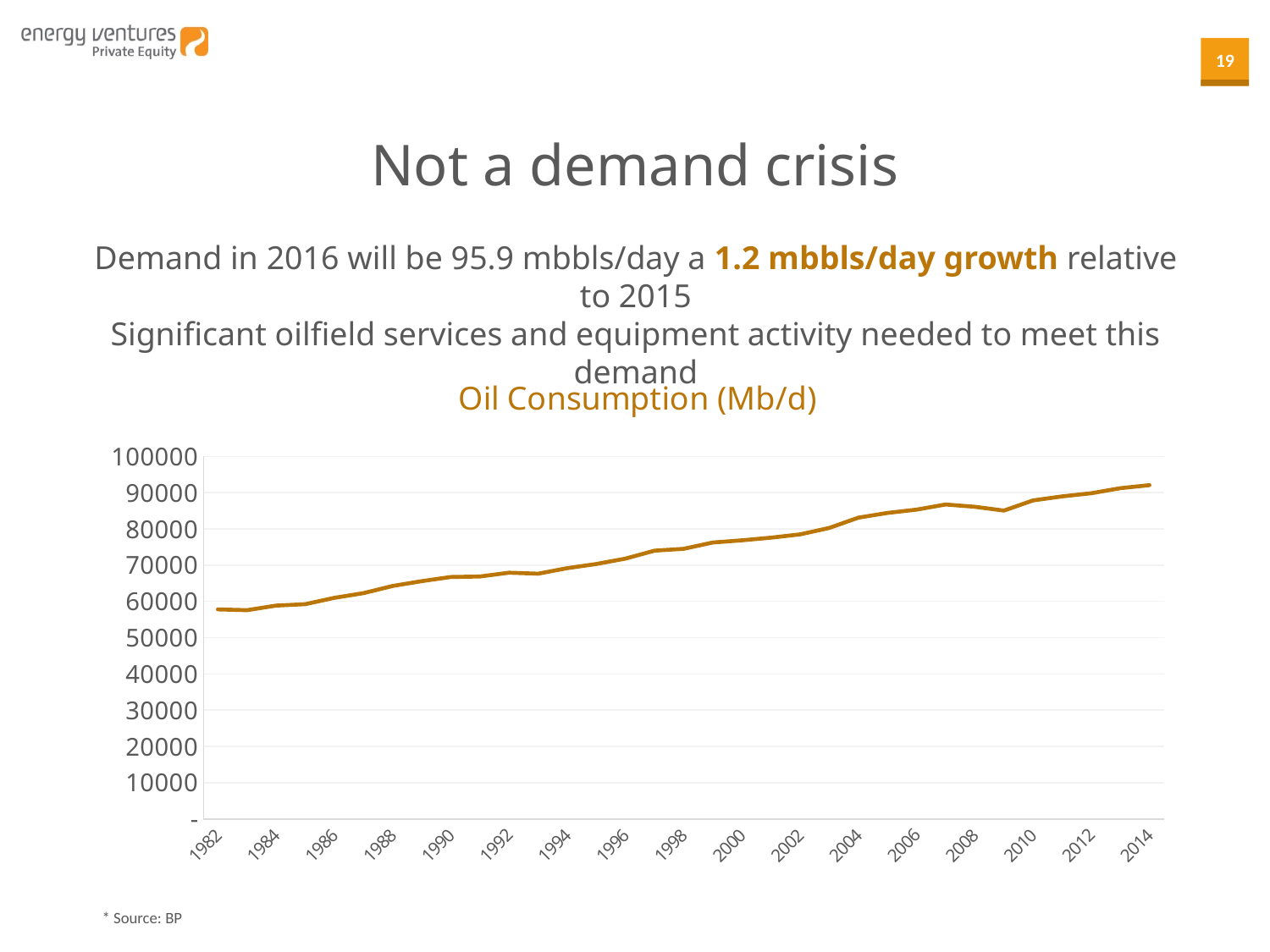
How many year labels are shown on the x axis? 17 Is the value for 2000 greater or less than 70000? greater What kind of chart is shown on the slide? line chart Is the value for 1990 greater or less than 80000? less What is the title of the chart? Oil Consumption (Mb/d) Is the value for 1982 greater or less than 50000? greater Do the values in the chart generally rise or fall from 1982 to 2014? rise How many data series are plotted in the chart? 1 Which year shows the highest oil consumption in the chart? 2014 Which year has the larger oil consumption, 1994 or 2004? 2004